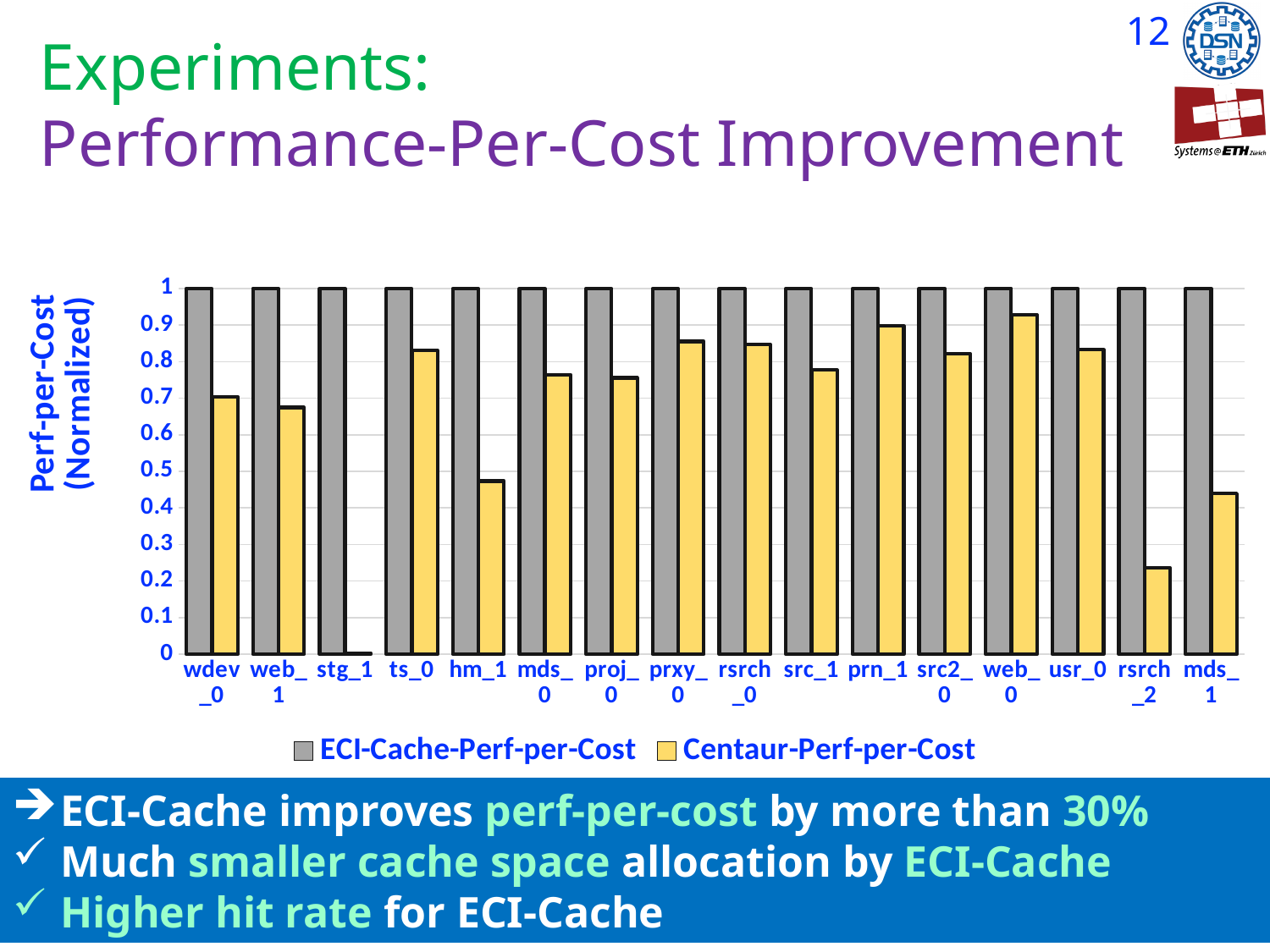
Is the Centaur-Perf-per-Cost value for web_0 greater or less than 0.9? greater Is the Centaur-Perf-per-Cost value for rsrch_2 greater or less than 0.3? less Is the Centaur-Perf-per-Cost value for ts_0 greater or less than 0.8? greater Which has the larger Centaur-Perf-per-Cost value, rsrch_2 or mds_1? mds_1 Which has the larger Centaur-Perf-per-Cost value, hm_1 or mds_0? mds_0 What kind of chart is shown on the slide? bar chart How many series does the legend list? 2 What is the ECI-Cache-Perf-per-Cost value for mds_1? 1 What is the label of the y axis? Perf-per-Cost (Normalized) What is the ECI-Cache-Perf-per-Cost value for wdev_0? 1 How many workload categories are shown on the x axis? 16